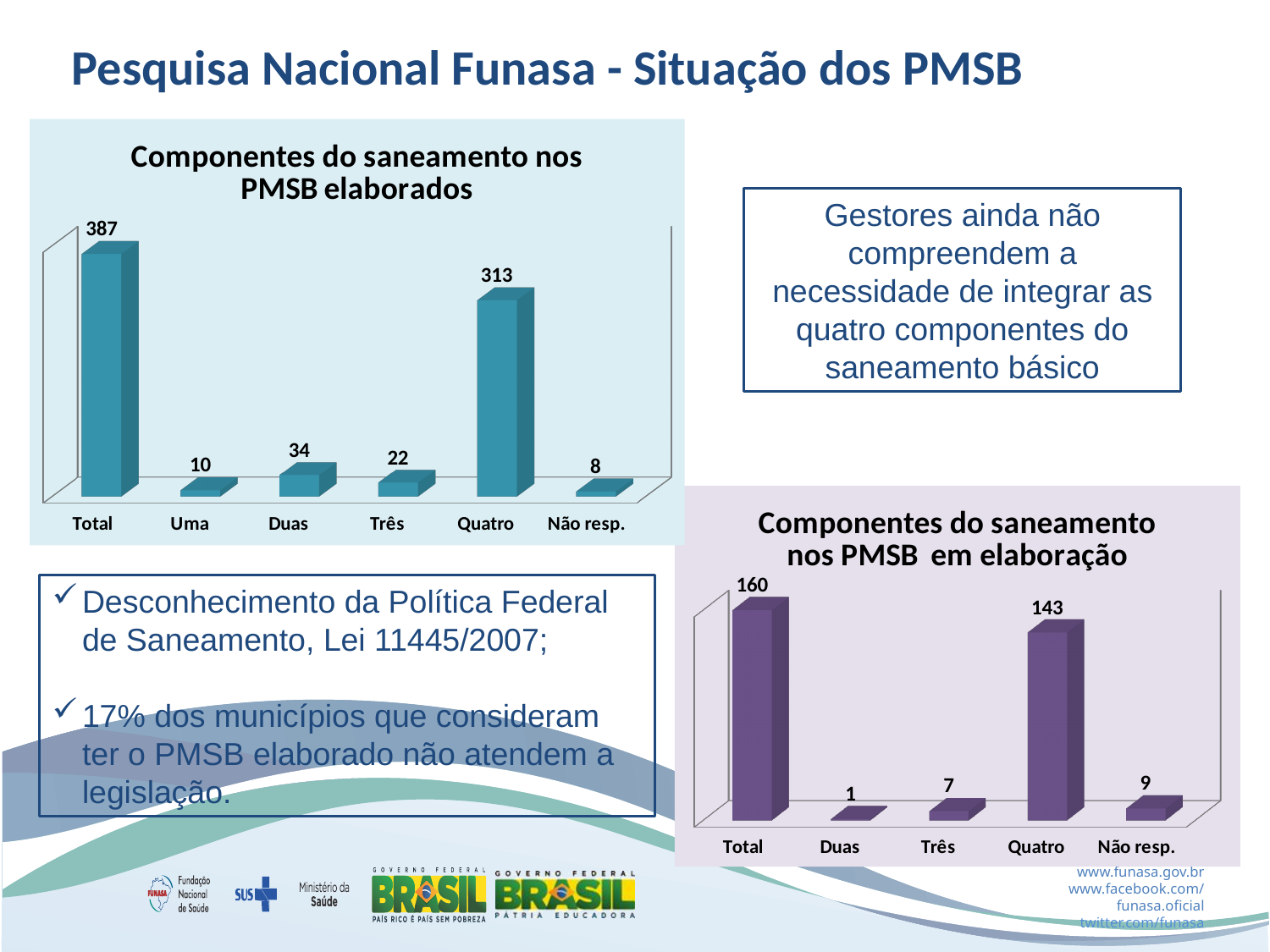
In the chart 'Componentes do saneamento nos PMSB elaborados', what is the difference between the values for Quatro and Uma? 303 In the chart 'Componentes do saneamento nos PMSB em elaboração', which category has the lowest value? Duas In the chart 'Componentes do saneamento nos PMSB em elaboração', which is larger, the value for Quatro or the value for Não resp.? Quatro In the chart 'Componentes do saneamento nos PMSB em elaboração', what is the value for Três? 7 In the chart 'Componentes do saneamento nos PMSB em elaboração', what is the difference between the values for Total and Quatro? 17 In the chart 'Componentes do saneamento nos PMSB elaborados', what is the value for Quatro? 313 In the chart 'Componentes do saneamento nos PMSB em elaboração', what is the value for Total? 160 In the chart 'Componentes do saneamento nos PMSB em elaboração', how many categories are shown on the x axis? 5 In the chart 'Componentes do saneamento nos PMSB elaborados', what is the value for Duas? 34 What kind of chart is 'Componentes do saneamento nos PMSB elaborados'? Bar chart In the chart 'Componentes do saneamento nos PMSB elaborados', which category other than Total has the lowest value? Não resp. In the chart 'Componentes do saneamento nos PMSB elaborados', how many categories are shown on the x axis? 6